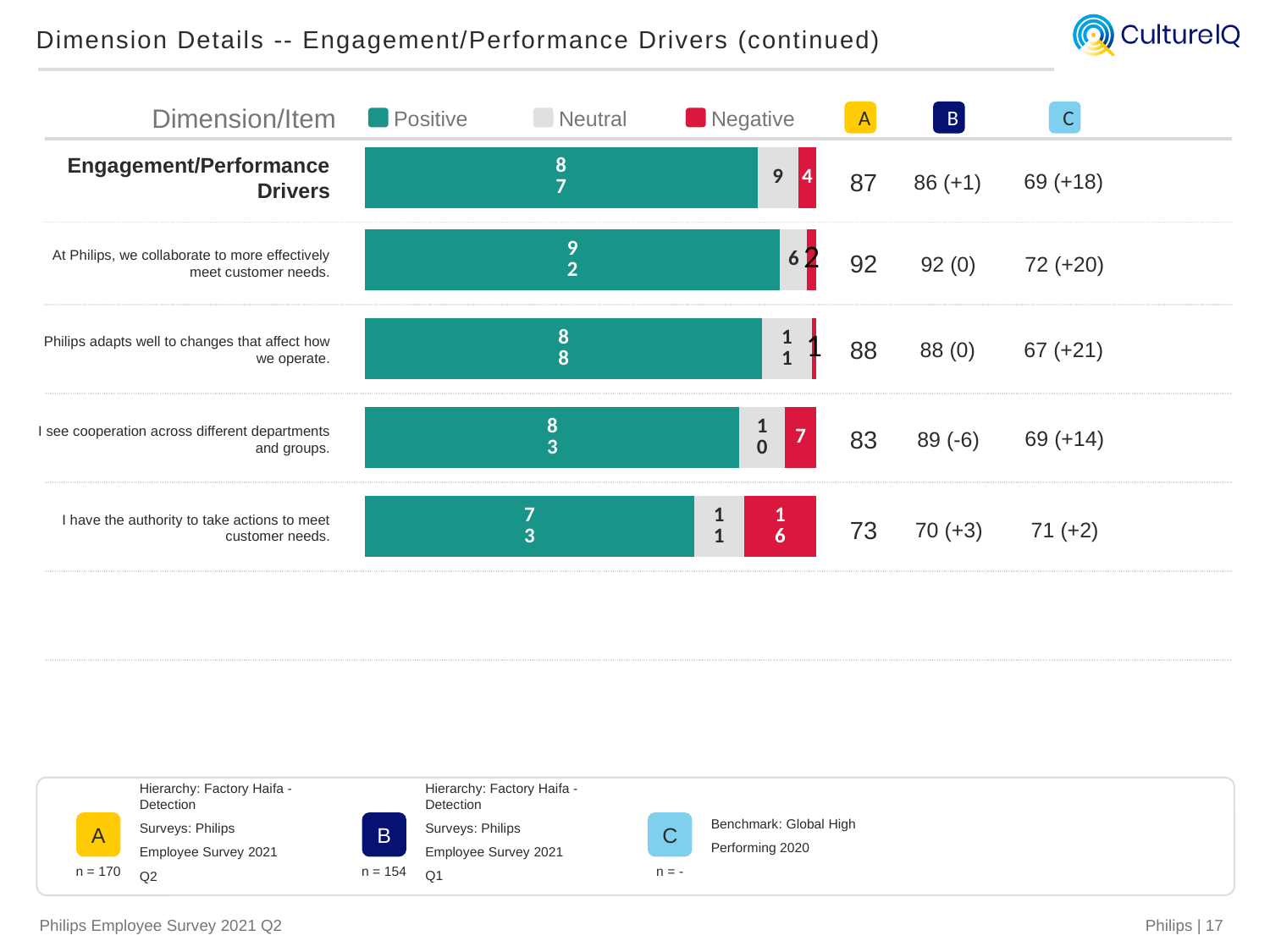
Which has a larger Negative value: "I see cooperation across different departments and groups." or "Engagement/Performance Drivers"? I see cooperation across different departments and groups. What kind of chart is shown on the slide? Stacked bar chart What is the Negative value for "I have the authority to take actions to meet customer needs."? 16 What is the Positive value for "At Philips, we collaborate to more effectively meet customer needs."? 92 How many series does the legend list? 3 What colour represents the Negative series in the legend? Red What is the total of the stacked bar for "I have the authority to take actions to meet customer needs."? 100 How many items (rows) are shown in the chart? 5 Which item has the highest Positive value? At Philips, we collaborate to more effectively meet customer needs. What is the difference between the Positive values for "Engagement/Performance Drivers" and "I see cooperation across different departments and groups."? 4 Which item has the lowest Positive value? I have the authority to take actions to meet customer needs. What is the Neutral value for "Philips adapts well to changes that affect how we operate."? 11